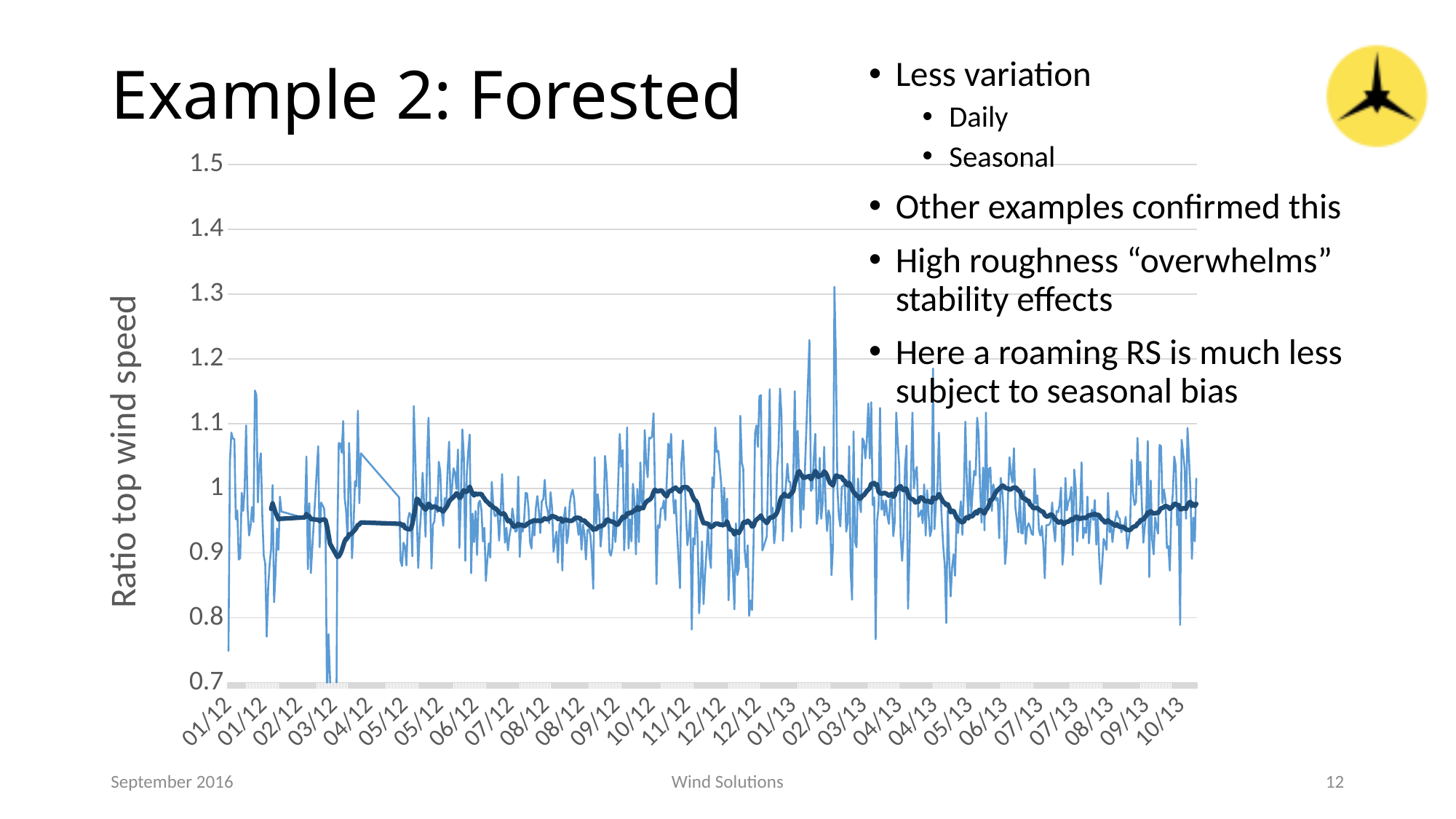
Is the highest peak of the light blue line greater or less than 1.2? greater How many tick labels are shown on the horizontal axis of the chart? 28 Does the dark blue line ever drop below 0.8? No Does the dark blue line rise or fall between 12/12 and 02/13? rise Is the lowest dip of the light blue line (near 03/12) greater or less than 0.8? less How many lines (series) are plotted on the chart? 2 What is the last date label on the horizontal axis? 10/13 What is the label of the vertical axis of the chart? Ratio top wind speed What kind of chart is shown on the slide? line chart What is the first date label on the horizontal axis? 01/12 What is the highest value shown on the vertical axis of the chart? 1.5